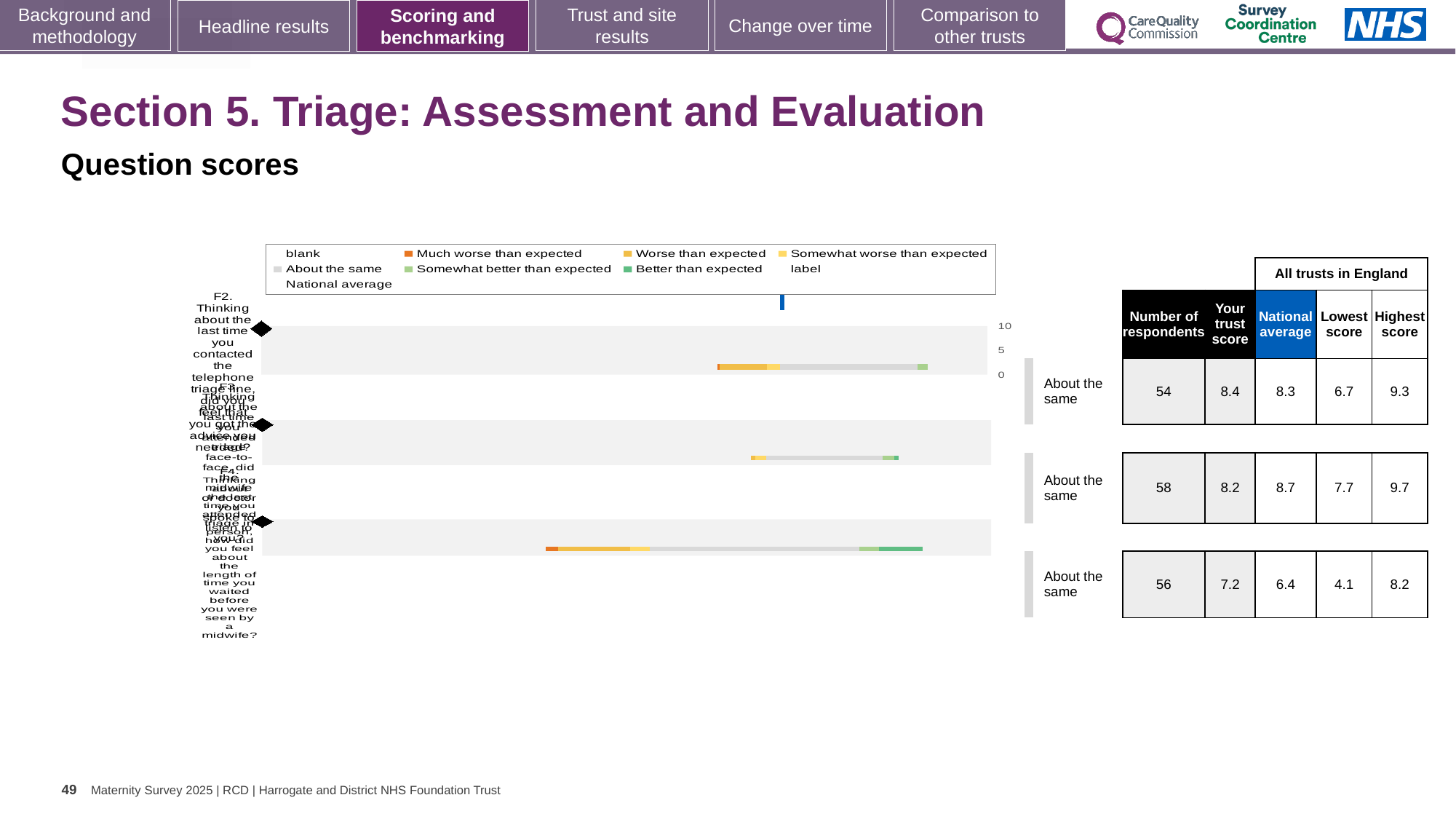
According to the table, how many respondents answered the second question (F3)? 58 According to the table, what is the trust score for the first question (F2)? 8.4 According to the table, what is the difference between the trust score and the national average for F4? 0.8 According to the table, is the trust score for F3 higher or lower than the national average for F3? lower How many questions (categories) are plotted on the chart? 3 What colour does the legend use for 'Much worse than expected'? orange According to the table, what is the national average for the third question (F4)? 6.4 What colour does the legend use for 'Better than expected'? green What kind of chart is shown on the slide? bar chart According to the table, which question has the lowest trust score? F4 What is the highest value shown on the chart's axis? 10